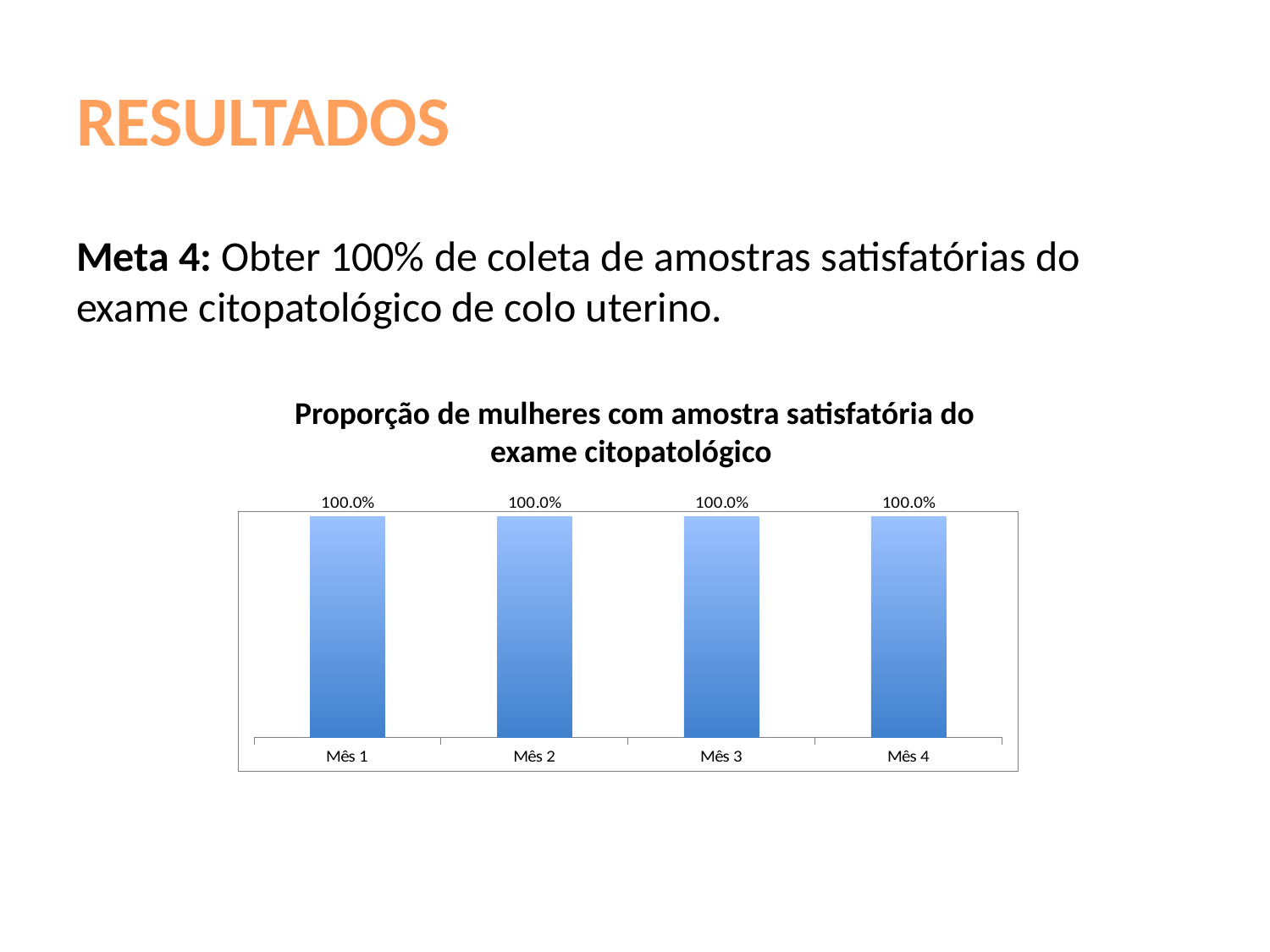
What is the value for Mês 1? 100.0% How many categories are shown on the x axis? 4 What is the difference between the values for Mês 2 and Mês 4? 0.0% What is the value for Mês 4? 100.0% Do the values rise, fall or stay the same from Mês 1 to Mês 4? stay the same What is the value for Mês 3? 100.0% What kind of chart is shown on the slide? bar chart What is the title of the chart? Proporção de mulheres com amostra satisfatória do exame citopatológico What colour are the bars in the chart? blue